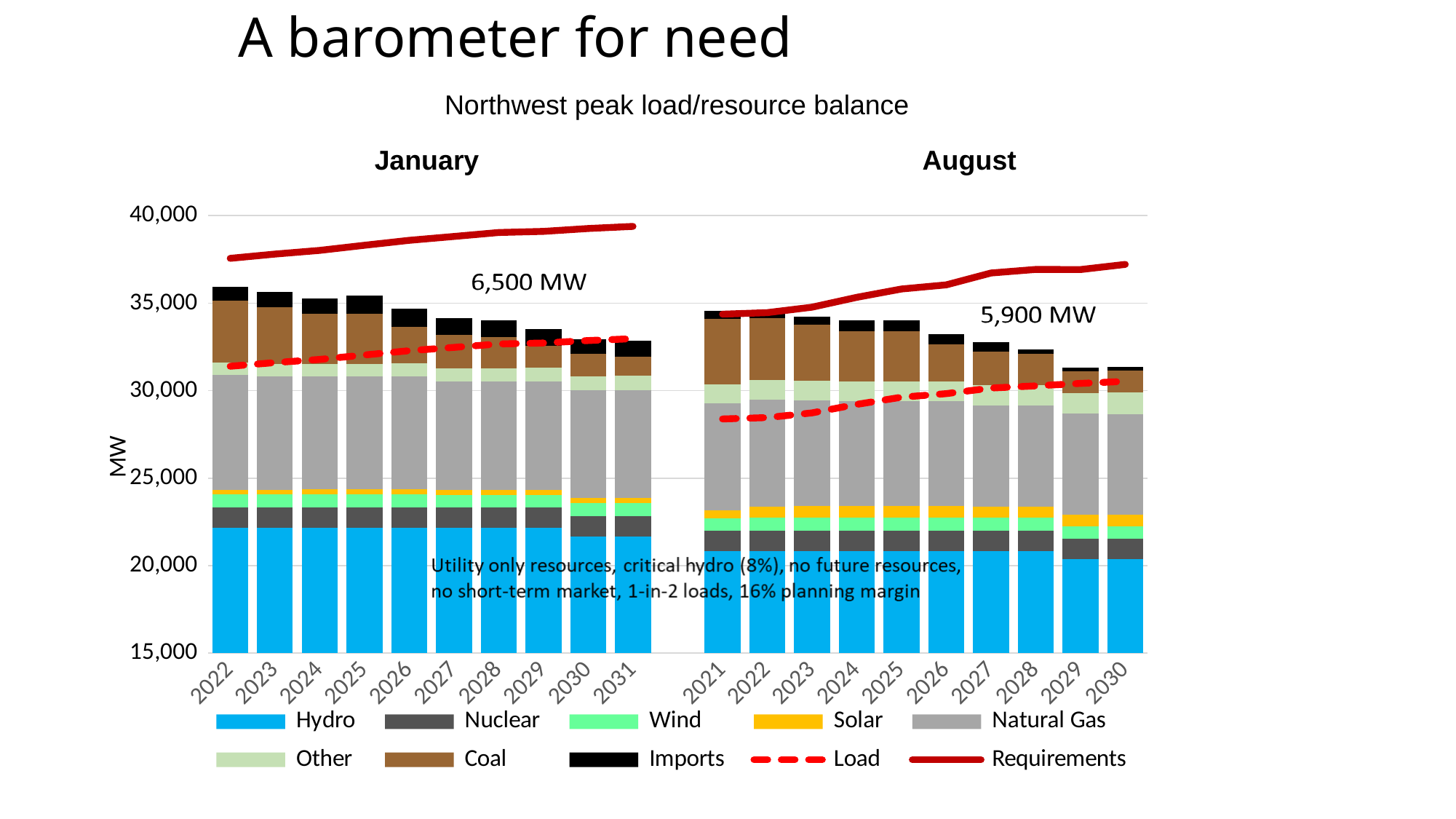
What is the label on the vertical axis of the chart? MW What kind of chart is shown on the slide? stacked bar and line chart In the January panel, is the total height of the 2022 bar greater or less than 35,000? greater What gap in MW is labelled on the January panel of the chart? 6,500 MW How many years are plotted in the January panel of the chart? 10 In the August panel, which bar is taller in total: 2021 or 2030? 2021 How many series does the chart legend list? 10 What gap in MW is labelled on the August panel of the chart? 5,900 MW In the August panel, is the Load value for 2021 greater or less than 30,000? less In the January panel, is the total height of the 2031 bar greater or less than 35,000? less What is the title of the chart? Northwest peak load/resource balance In the January panel, does the Requirements line rise or fall from 2022 to 2031? rises